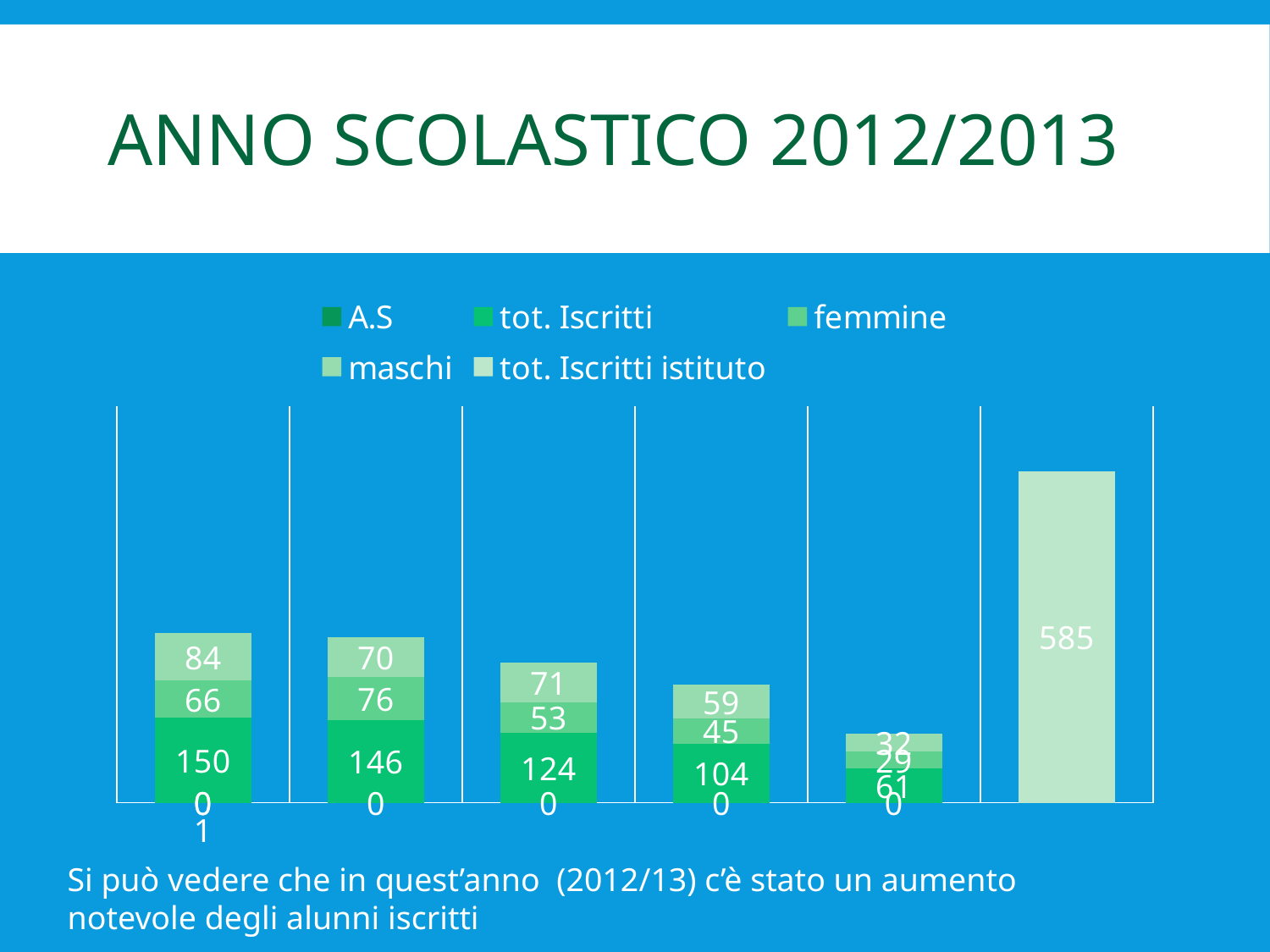
What is the femmine value shown in the second bar from the left? 76 Which bar has the highest tot. Iscritti value? the first (leftmost) bar, 150 What value is labelled on the tot. Iscritti istituto bar (the rightmost bar)? 585 What is the maschi value shown in the third bar from the left? 71 Is the maschi value larger in the first bar (84) or in the second bar (70)? the first bar (84) What is the total of the tot. Iscritti, femmine and maschi segments in the first bar (150, 66, 84)? 300 Which bar has the lowest tot. Iscritti value? the fifth bar, 61 How many series does the chart legend list? 5 How many stacked bars are plotted in the chart? 6 What is the difference between the tot. Iscritti values of the first bar (150) and the fourth bar (104)? 46 What kind of chart is shown on the slide? bar chart What is the tot. Iscritti value shown in the first (leftmost) bar? 150